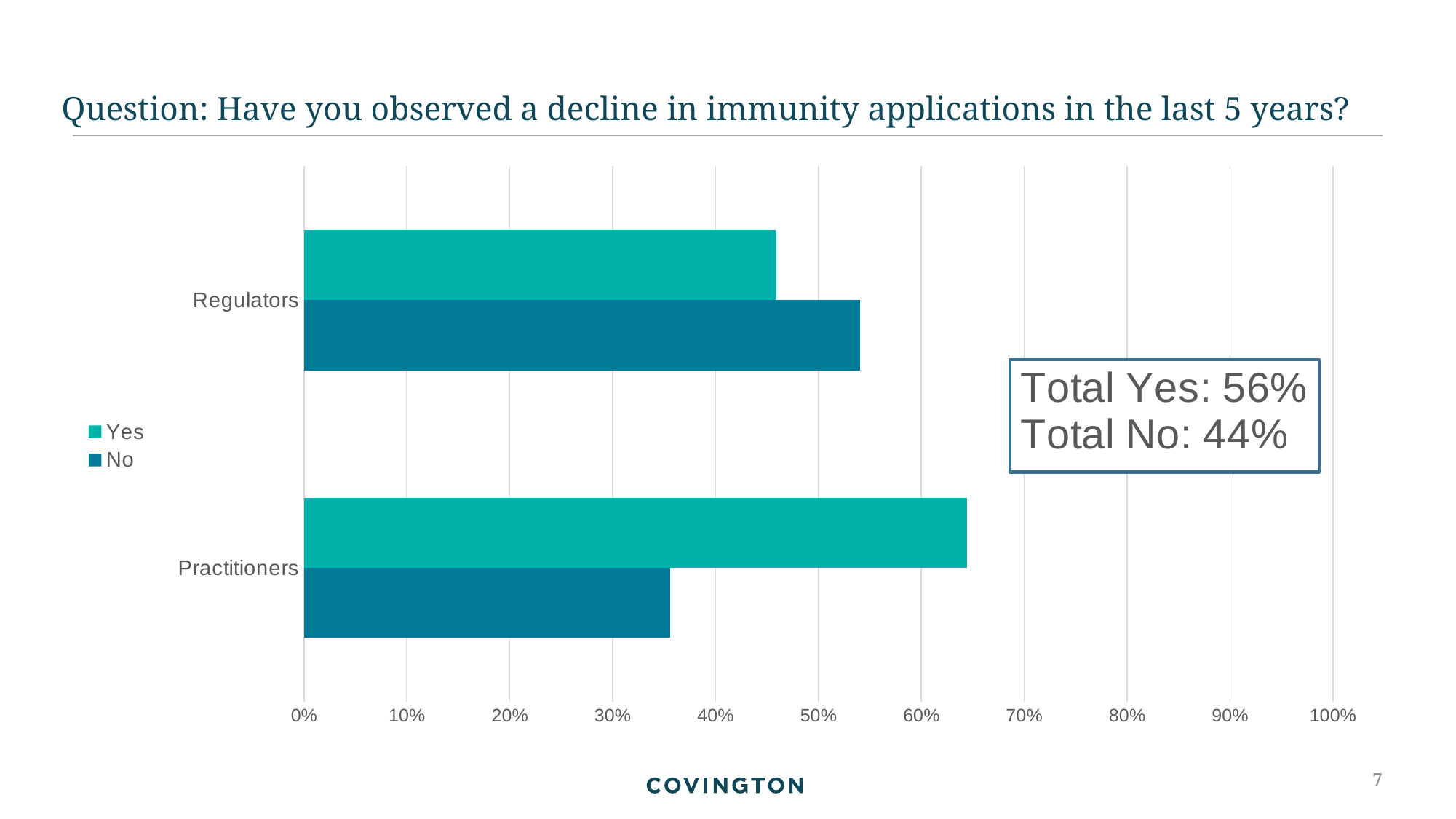
What kind of chart is shown on the slide? Bar chart According to the text box on the slide, what is the Total Yes percentage? 56% How many series does the chart's legend list? 2 Which series has the longer bar for Regulators, Yes or No? No Is the Yes value for Practitioners greater or less than 60%? greater Which category has the lowest No value? Practitioners Is the Yes value for Regulators greater or less than 50%? less Which category has the highest Yes value? Practitioners Is the No value for Practitioners greater or less than 40%? less Which series has the longer bar for Practitioners, Yes or No? Yes How many categories are shown on the vertical axis of the chart? 2